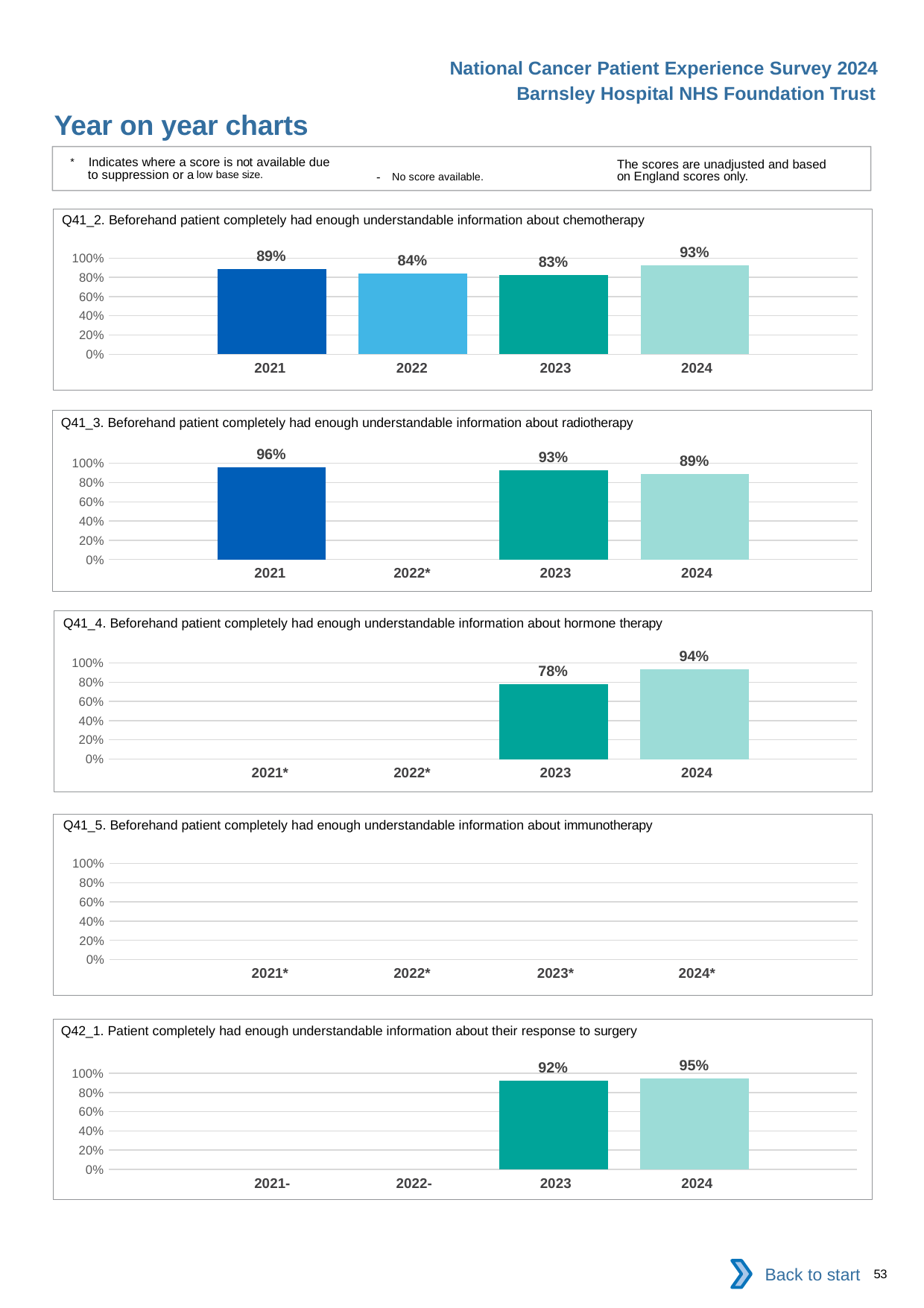
In the Q41_3 chart (radiotherapy), which year has no score available due to suppression or a low base size? 2022 In the Q42_1 chart (response to surgery), what is the value for 2024? 95% In the Q41_4 chart (hormone therapy), what is the difference between the 2024 and 2023 values? 16% In the Q41_2 chart (chemotherapy), what is the difference between the 2024 and 2023 values? 10% What kind of chart is the Q42_1 chart (response to surgery)? bar chart In the Q41_3 chart (radiotherapy), is the value for 2023 larger or smaller than the value for 2024? larger In the Q41_2 chart (chemotherapy), which year has the lowest value? 2023 In the Q41_3 chart (radiotherapy), what is the value for 2021? 96% In the Q41_2 chart (chemotherapy), what is the value for 2022? 84% In the Q41_5 chart (immunotherapy), how many years have a bar plotted? 0 In the Q41_2 chart (chemotherapy), which year has the highest value? 2024 In the Q41_4 chart (hormone therapy), what is the value for 2023? 78%